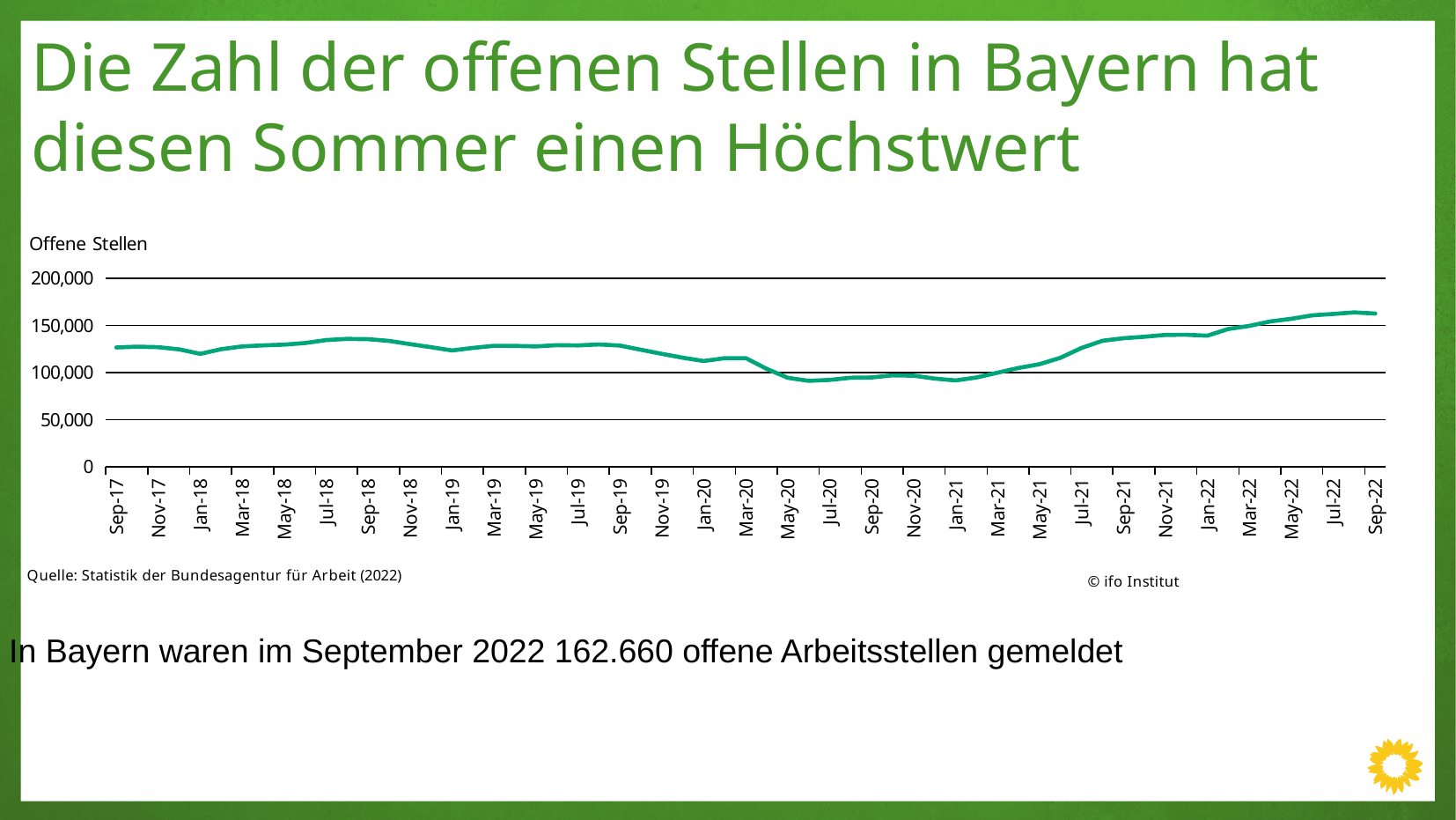
Is the value for Jul-20 greater or less than 100,000? less What is the label on the y axis of the chart? Offene Stellen Is the value for Jul-18 greater or less than 150,000? less Which is larger, the value for Sep-17 or the value for Jan-21? Sep-17 Which is larger, the value for Sep-22 or the value for Jul-20? Sep-22 Is the value for Sep-22 greater or less than 150,000? greater According to the slide, how many offene Arbeitsstellen were reported in Bayern in September 2022? 162.660 What is the source given below the chart? Statistik der Bundesagentur für Arbeit (2022) Do the values rise or fall between Mar-21 and Sep-22? rise Do the values rise or fall between Mar-20 and Jul-20? fall What kind of chart is shown on the slide? line chart